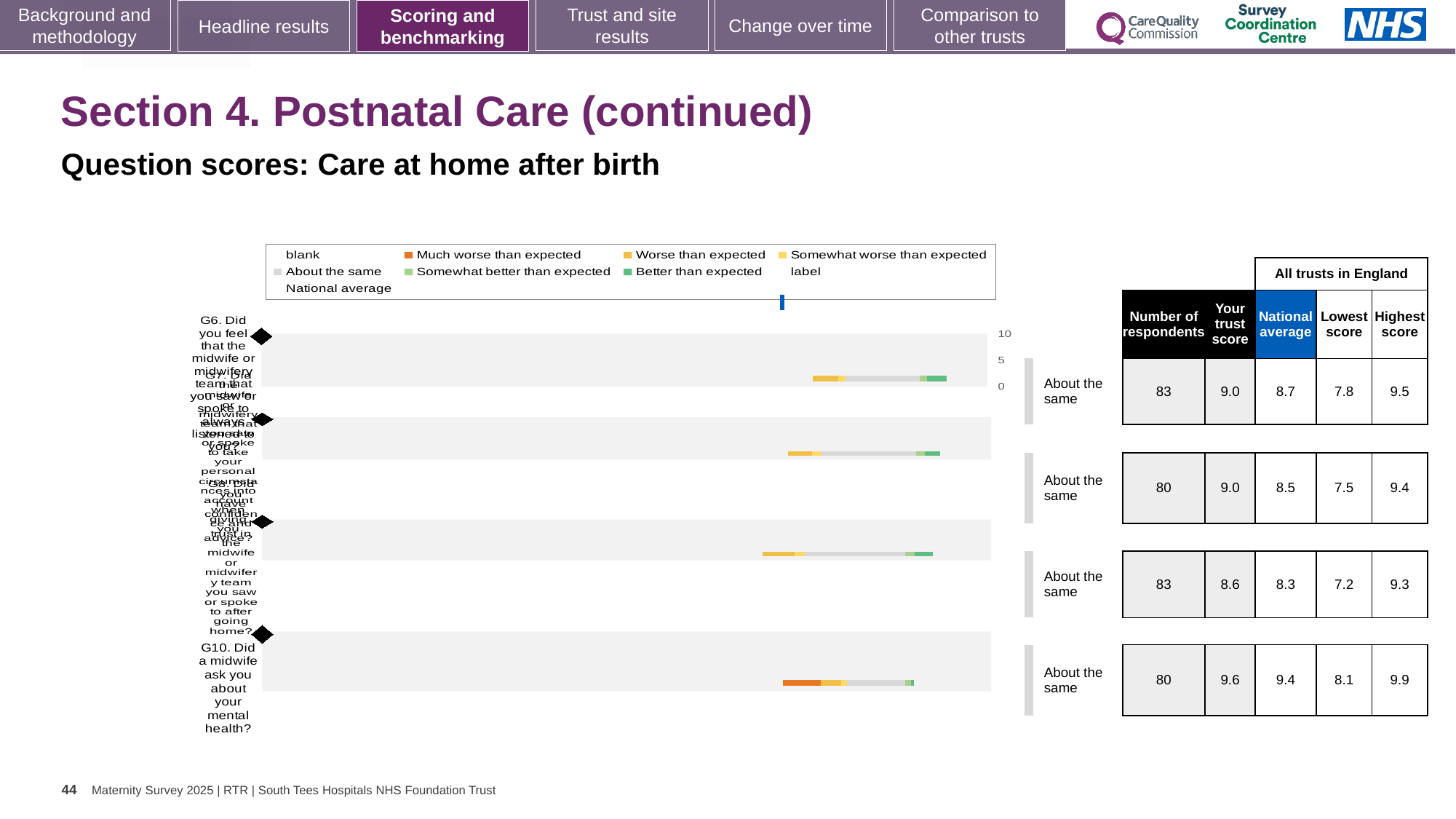
How many question bars are plotted in the chart? 4 What is the 'Your trust score' for question G10 (Did a midwife ask you about your mental health?)? 9.6 For question G10, which is larger: the trust score or the national average? the trust score How many respondents are listed for question G10 (Did a midwife ask you about your mental health?)? 80 What kind of chart is shown on the slide? bar chart Which question row has the highest 'Your trust score'? G10 What is the lowest 'Your trust score' shown in the table? 8.6 What is the national average for question G10 (Did a midwife ask you about your mental health?)? 9.4 What benchmark category is shown for every question row in the chart? About the same What is the lowest score among all trusts in England for the first question row (G6)? 7.8 What is the highest score among all trusts in England for question G10 (Did a midwife ask you about your mental health?)? 9.9 What is the difference between the trust score and the national average for question G10? 0.2